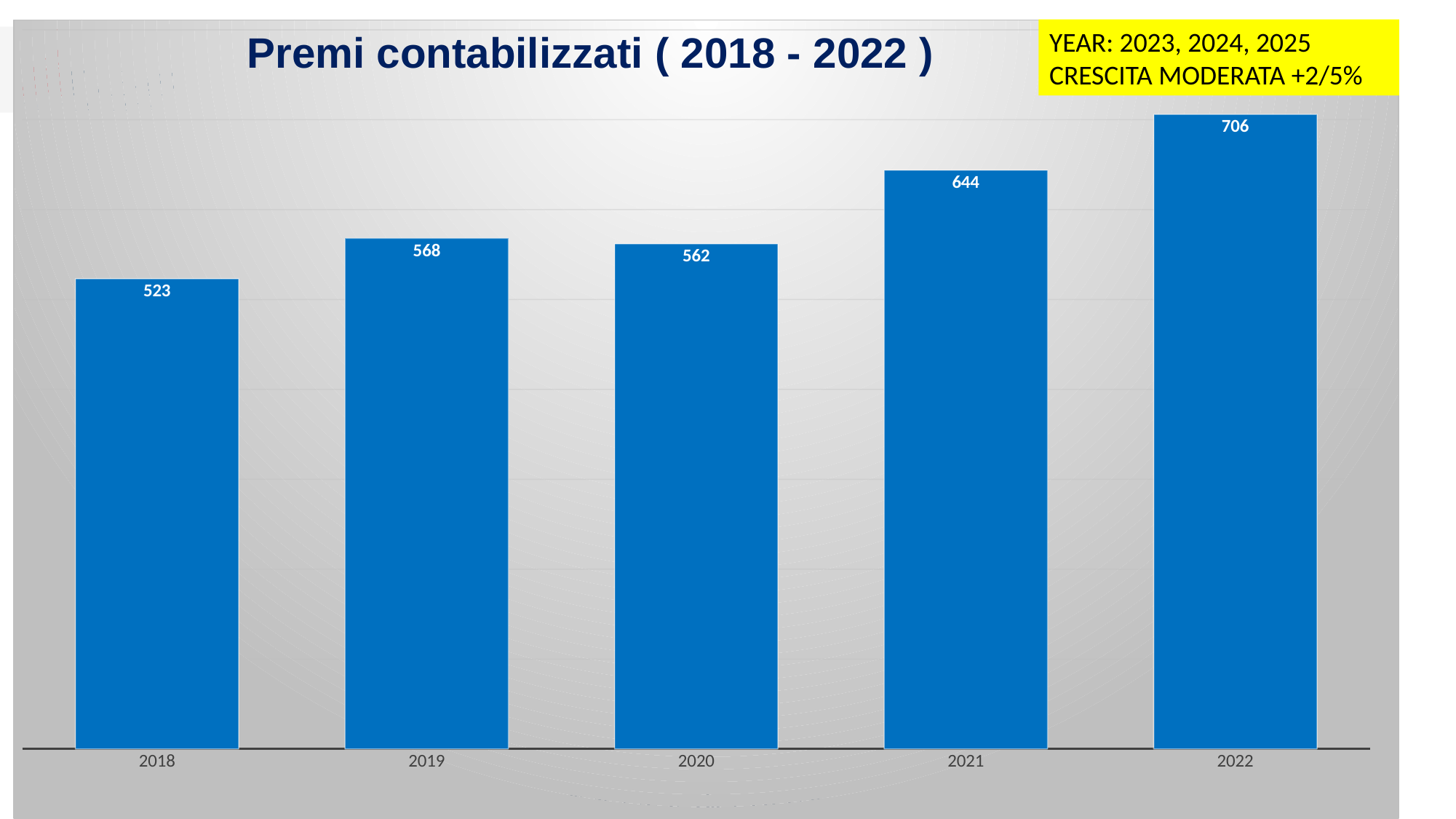
What is the value for 2020? 562 What is the value for 2018? 523 Which year has the lowest value? 2018 What is the title of the chart? Premi contabilizzati ( 2018 - 2022 ) What is the difference between the values for 2019 and 2018? 45 What is the difference between the values for 2022 and 2021? 62 How many years are shown on the x axis? 5 What is the value for 2022? 706 Which is larger, the value for 2019 or the value for 2020? 2019 Do the values generally rise or fall from 2018 to 2022? Rise Which year has the highest value? 2022 What kind of chart is shown on the slide? Bar chart